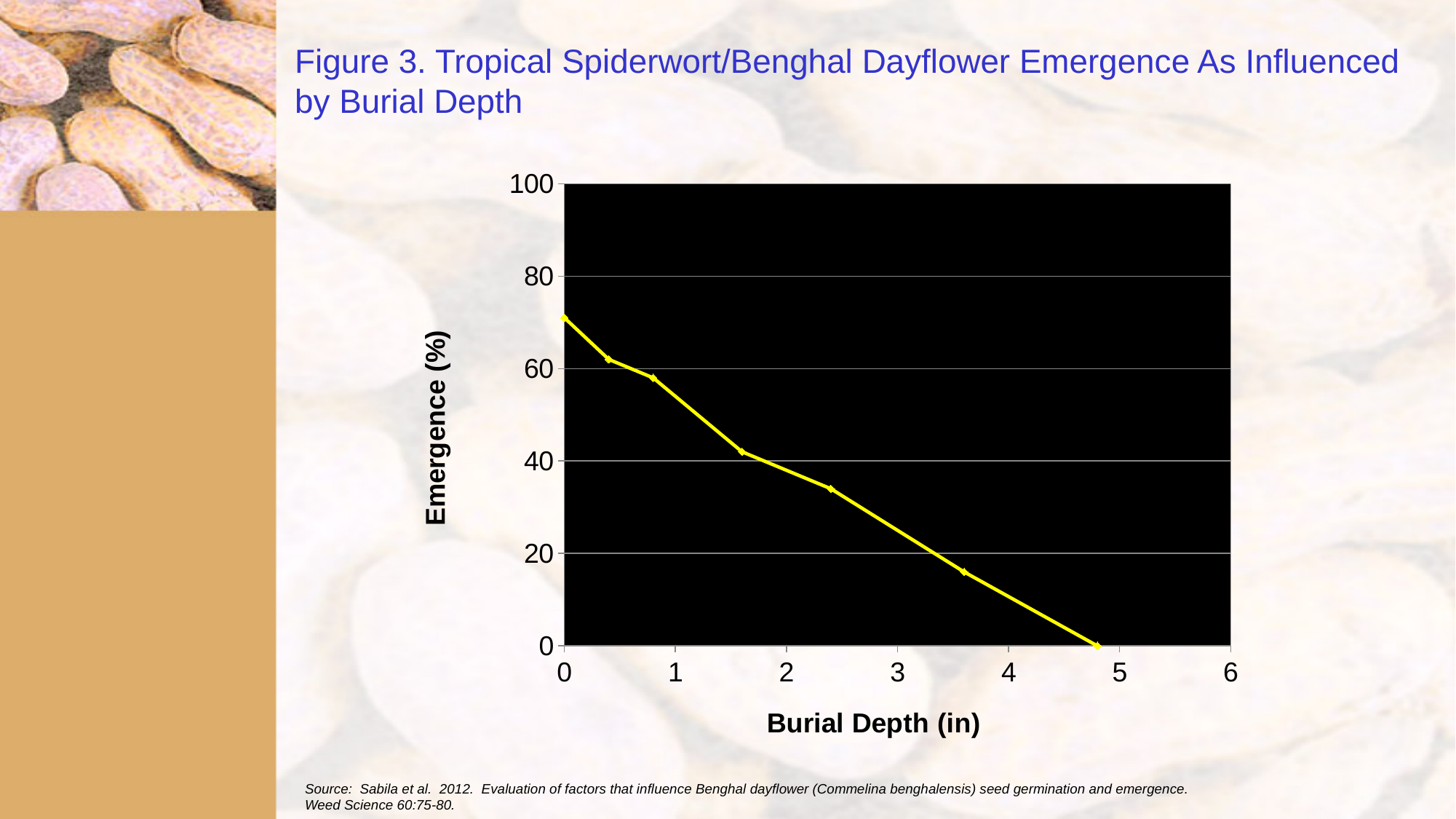
As burial depth increases along the x axis, does emergence rise or fall? fall What is the lowest emergence value plotted on the chart? 0 Is the emergence value at a burial depth of 0 in greater or less than 60? greater Is the emergence value at a burial depth of 0 in greater or less than 80? less What is the label of the y axis? Emergence (%) Which burial depth has the highest emergence, 0 in or 4.8 in? 0 in What is the label of the x axis? Burial Depth (in) Is the emergence value at the point nearest a burial depth of 2.4 in greater or less than 40? less What kind of chart is shown on the slide? line chart How many data points are plotted on the line? 7